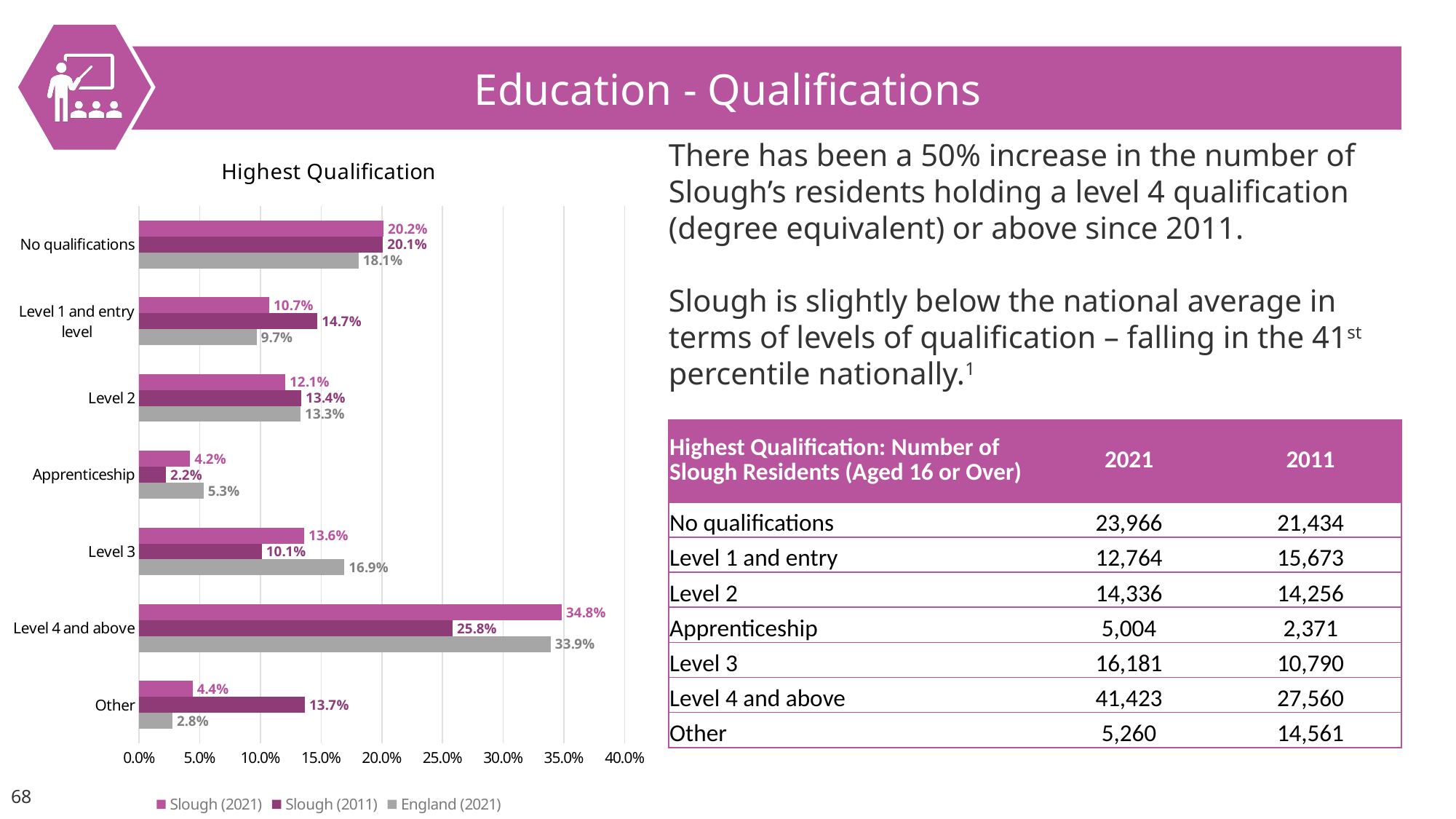
How many series does the legend list? 3 What is the difference between the Slough (2021) and Slough (2011) values for Level 4 and above? 9.0% What is the Slough (2021) value for Level 4 and above? 34.8% Is the Slough (2011) value for Level 1 and entry level greater or less than 10.0%? greater What is the England (2021) value for Apprenticeship? 5.3% Which is larger for Level 3: the Slough (2021) value or the England (2021) value? England (2021) What is the title of the chart? Highest Qualification What kind of chart is shown on the slide? Bar chart Which category has the lowest England (2021) value? Other Which category has the highest Slough (2021) value? Level 4 and above What is the Slough (2011) value for Other? 13.7% How many qualification categories are shown on the chart? 7